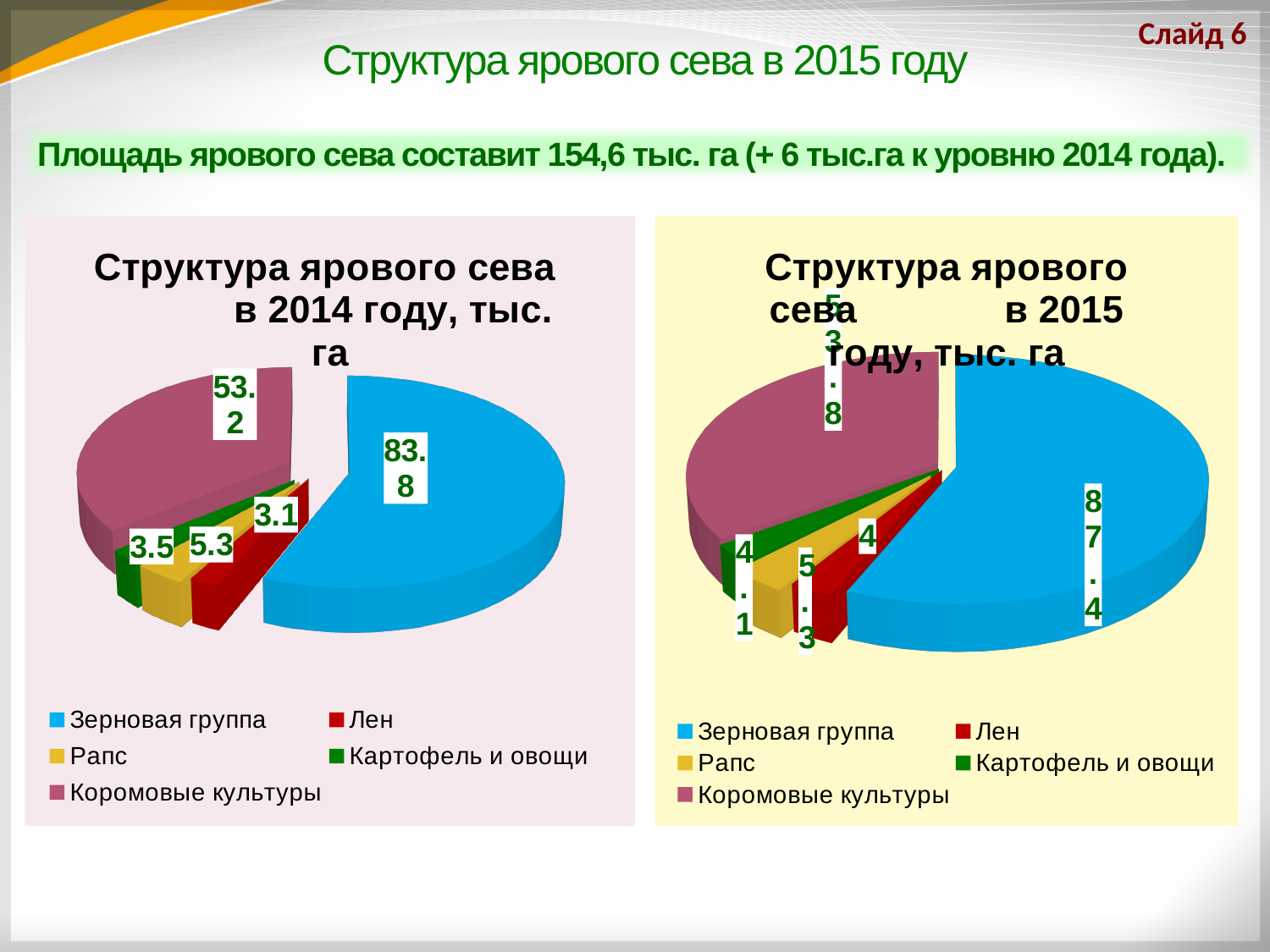
In the right chart (2015), which category has the largest slice? Зерновая группа In the left chart (2014), what is the value for Коромовые культуры? 53.2 What type of chart is the right chart (2015)? Pie chart How many categories does the legend of the left chart list? 5 In the left chart (2014), what is the difference between Зерновая группа and Коромовые культуры? 30.6 In the left chart (2014), what is the value for Рапс? 5.3 In the left chart (Структура ярового сева в 2014 году), what is the value for Зерновая группа? 83.8 In the right chart (2015), which is larger, Рапс or Лен? Рапс In the left chart (2014), which category has the smallest slice? Лен In the right chart (Структура ярового сева в 2015 году), what is the value for Зерновая группа? 87.4 In the right chart (2015), what is the value for Картофель и овощи? 4.1 In the left chart (2014), what colour is the slice for Зерновая группа? Blue